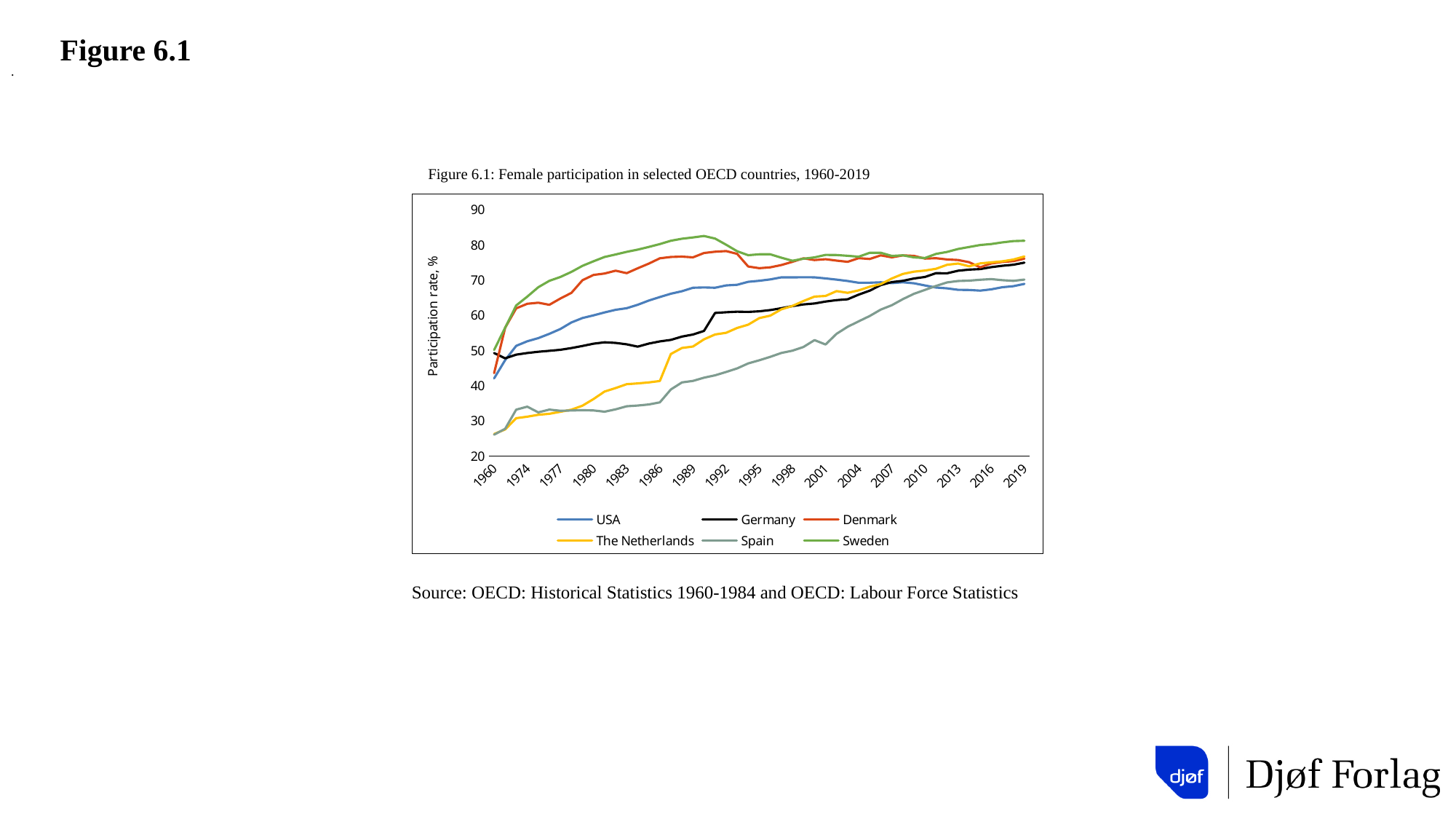
How many countries (series) does the legend list? 6 What is the title of the chart? Figure 6.1: Female participation in selected OECD countries, 1960-2019 In 1980, which has the higher participation rate, the USA or Germany? USA Does the participation rate for Spain rise or fall from 1960 to 2019? Rise Is the value for the USA in 1960 greater or less than 50? less Which country has the highest female participation rate in 2019? Sweden What kind of chart is shown on the slide? Line chart Is the value for Sweden in 1989 greater or less than 80? greater Which country has the highest female participation rate in 1989? Sweden Which country has the lowest female participation rate in 1986? Spain What is the label on the vertical axis? Participation rate, % Is the value for Spain in 1960 greater or less than 30? less